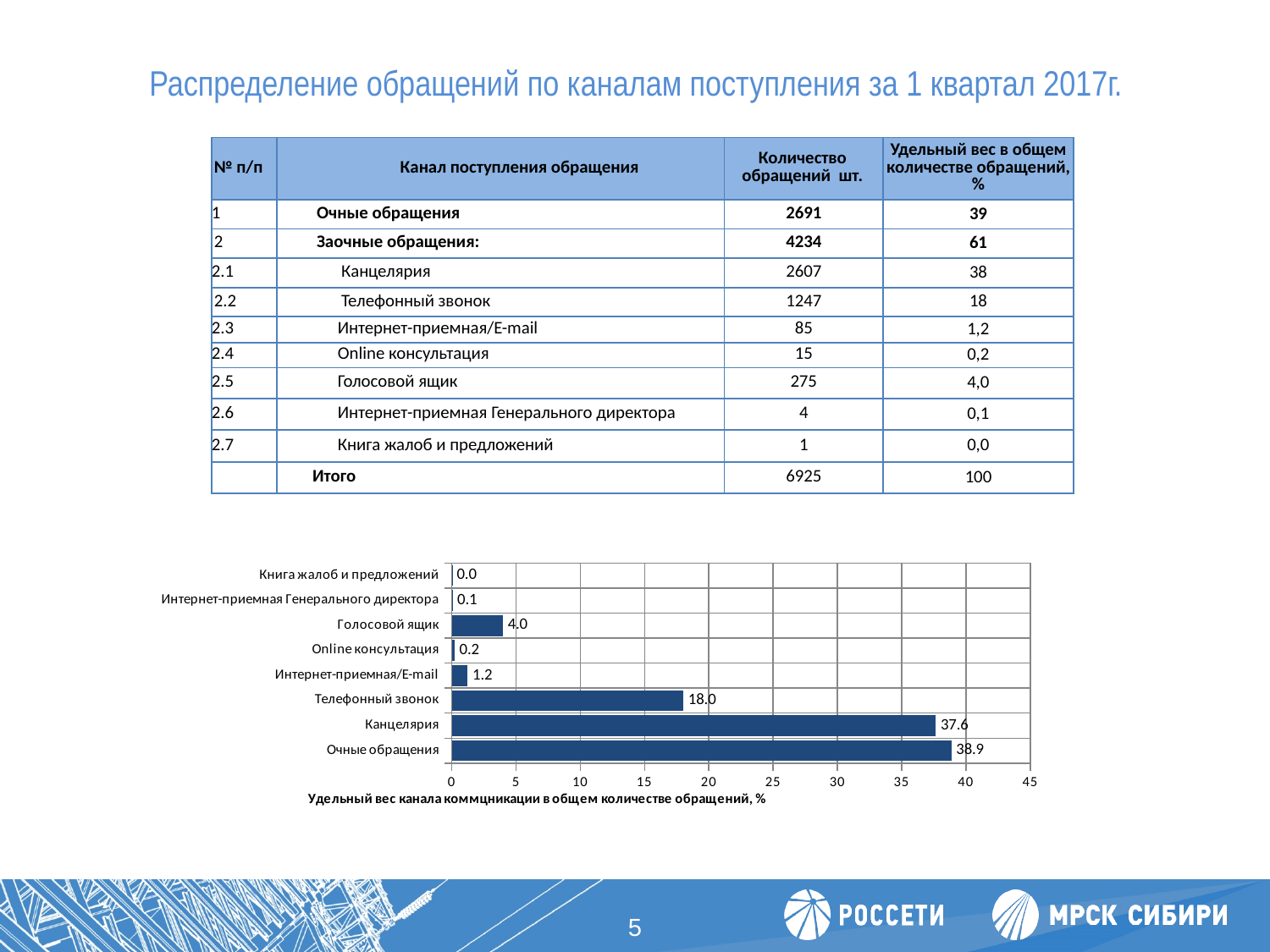
What is the value shown for Голосовой ящик in the bar chart? 4.0 In the bar chart, which is larger: the value for Голосовой ящик or the value for Интернет-приемная/E-mail? Голосовой ящик What is the value shown for Интернет-приемная/E-mail in the bar chart? 1.2 What type of chart is shown on the slide? bar chart In the bar chart, what is the difference between the values for Очные обращения and Телефонный звонок? 20.9 Which category has the highest value in the bar chart? Очные обращения What is the value shown for Телефонный звонок in the bar chart? 18.0 How many categories are plotted in the bar chart? 8 What is the maximum value shown on the horizontal axis of the bar chart? 45 Which category has the lowest value in the bar chart? Книга жалоб и предложений What is the value shown for Канцелярия in the bar chart? 37.6 Is the value for Канцелярия in the bar chart greater or less than 35? greater